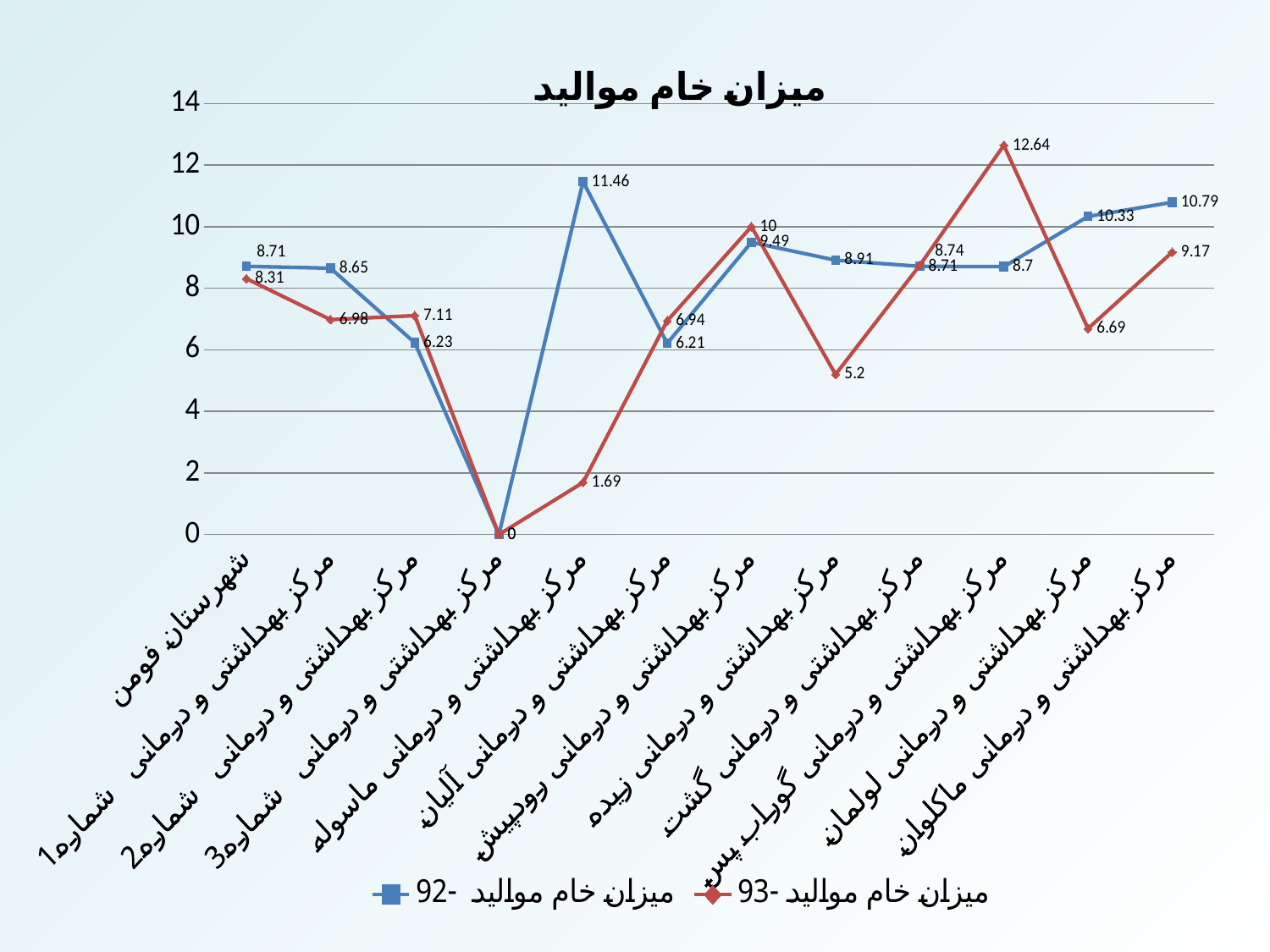
What is the difference between the 'میزان خام موالید -93' and 'میزان خام موالید -92' values for مرکز بهداشتی و درمانی گوراب پس? 3.94 How many categories are plotted along the x axis? 12 For مرکز بهداشتی و درمانی لولمان, which series has the larger value, 'میزان خام موالید -92' or 'میزان خام موالید -93'? میزان خام موالید -92 What is the value of the 'میزان خام موالید -93' series for مرکز بهداشتی و درمانی گوراب پس? 12.64 What colour is the line for the 'میزان خام موالید -93' series? red What is the value of the 'میزان خام موالید -92' series for مرکز بهداشتی و درمانی ماسوله? 11.46 How many series does the legend list? 2 Which category has the highest value in the 'میزان خام موالید -92' series? مرکز بهداشتی و درمانی ماسوله What is the title of the chart? میزان خام موالید Which category has the highest value in the 'میزان خام موالید -93' series? مرکز بهداشتی و درمانی گوراب پس What is the value of the 'میزان خام موالید -93' series for مرکز بهداشتی و درمانی زیده? 5.2 What type of chart is shown on the slide? line chart